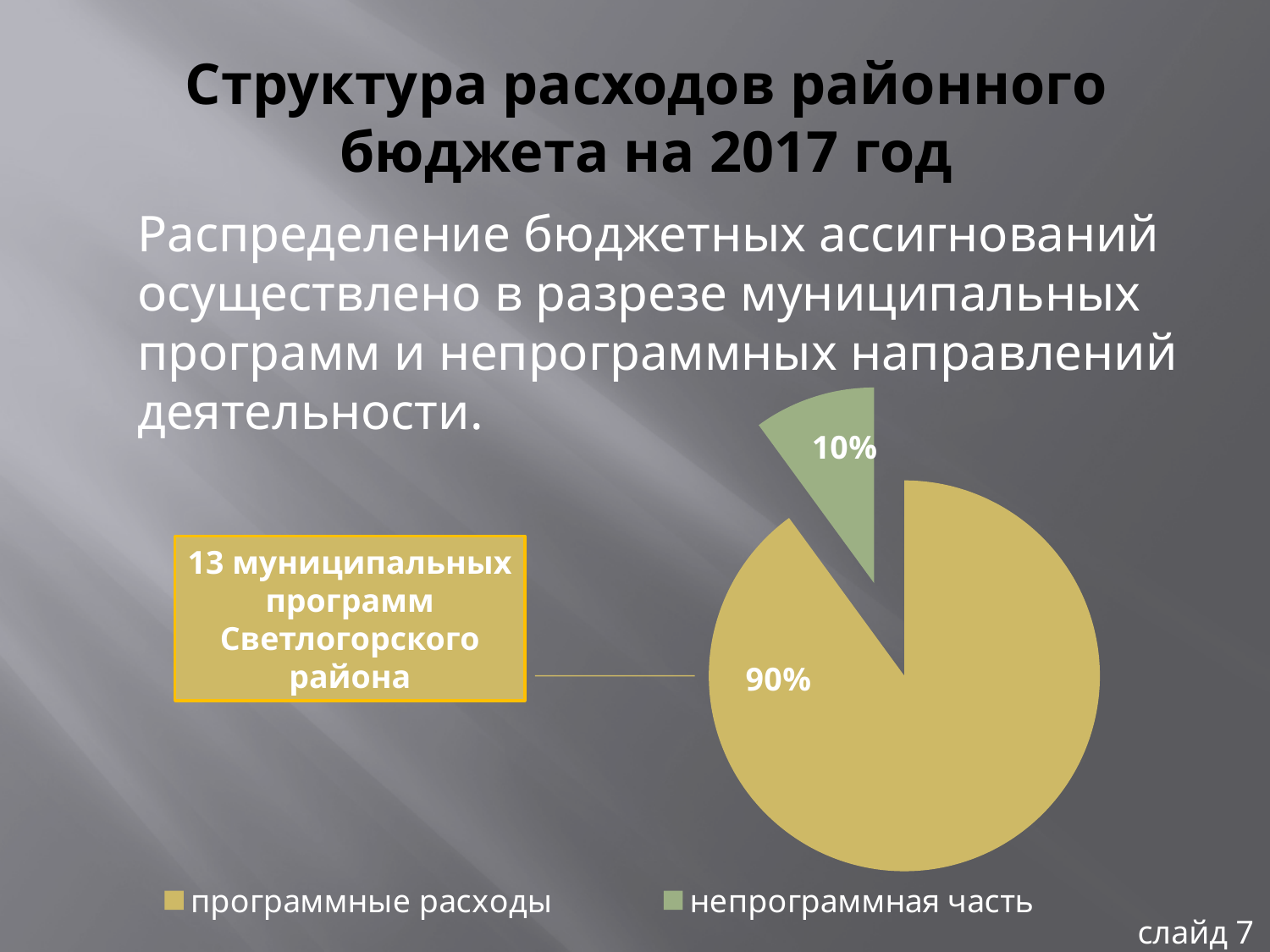
How many entries does the legend list? 2 Which slice of the pie is the smallest? непрограммная часть What is the difference in percentage points between 'программные расходы' and 'непрограммная часть'? 80 What colour is the 'непрограммная часть' slice? green Which slice of the pie is the largest? программные расходы What share of the pie does 'программные расходы' take? 90% Which is larger: 'программные расходы' or 'непрограммная часть'? программные расходы How many slices does the pie chart have? 2 What colour is the 'программные расходы' slice? yellow Is the share for 'непрограммная часть' greater or less than 50%? less What kind of chart is shown on the slide? pie chart What share of the pie does 'непрограммная часть' take? 10%